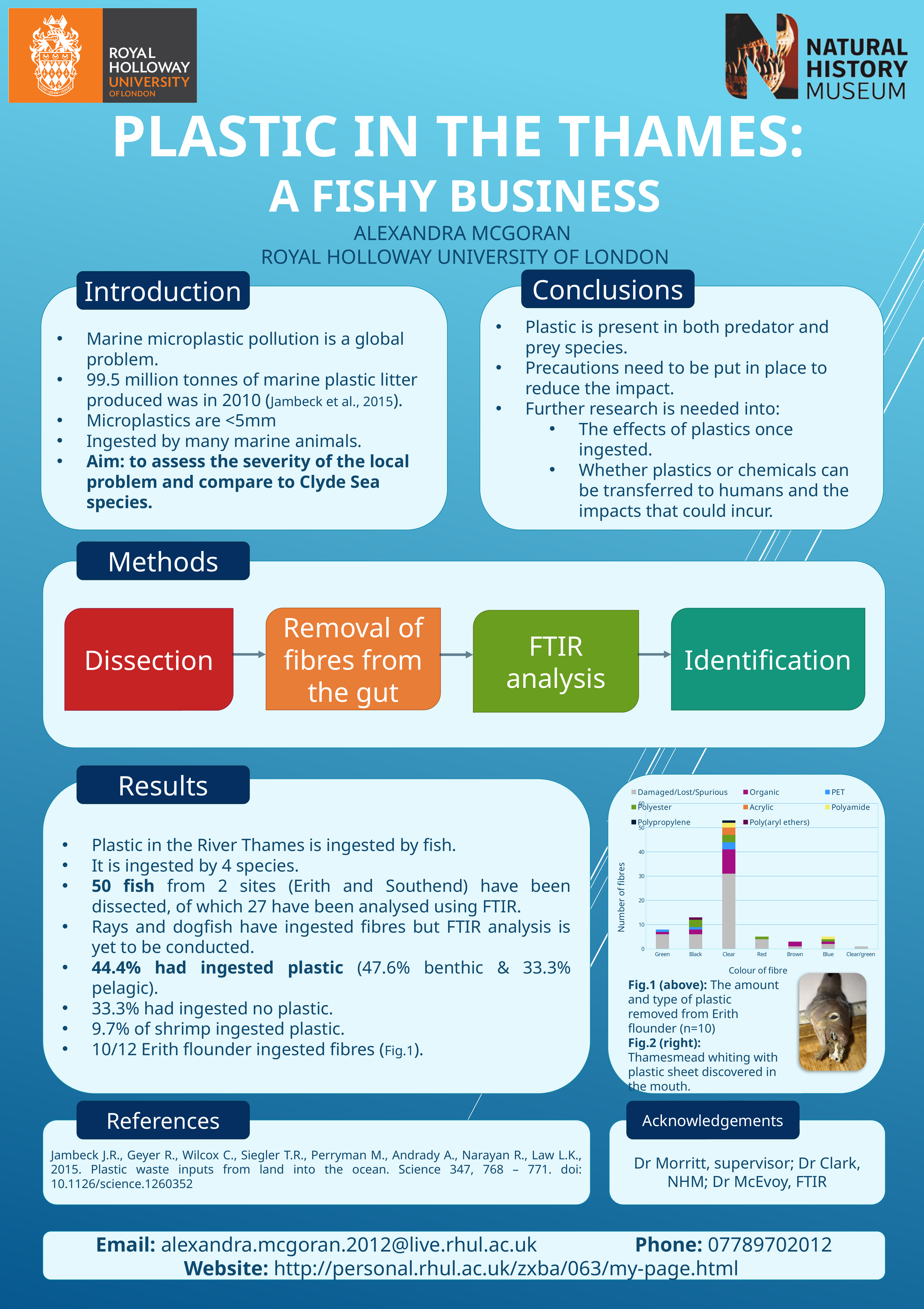
Is the total number of fibres for Green greater or less than 10? less How many fibre colour categories are shown on the x axis of the chart? 7 Is the total number of fibres for Black greater or less than 10? greater Which has a larger total number of fibres in the chart, Clear or Black? Clear Which colour of fibre has the highest total number of fibres in the chart? Clear Which colour of fibre has the lowest total number of fibres in the chart? Clear/green Is the total number of fibres for Clear greater or less than 50? greater Which has a larger total number of fibres in the chart, Black or Green? Black What is the label of the x axis of the chart? Colour of fibre What kind of chart is shown in Fig.1 on the slide? Stacked bar chart What is the label of the y axis of the chart? Number of fibres How many series does the chart's legend list? 8